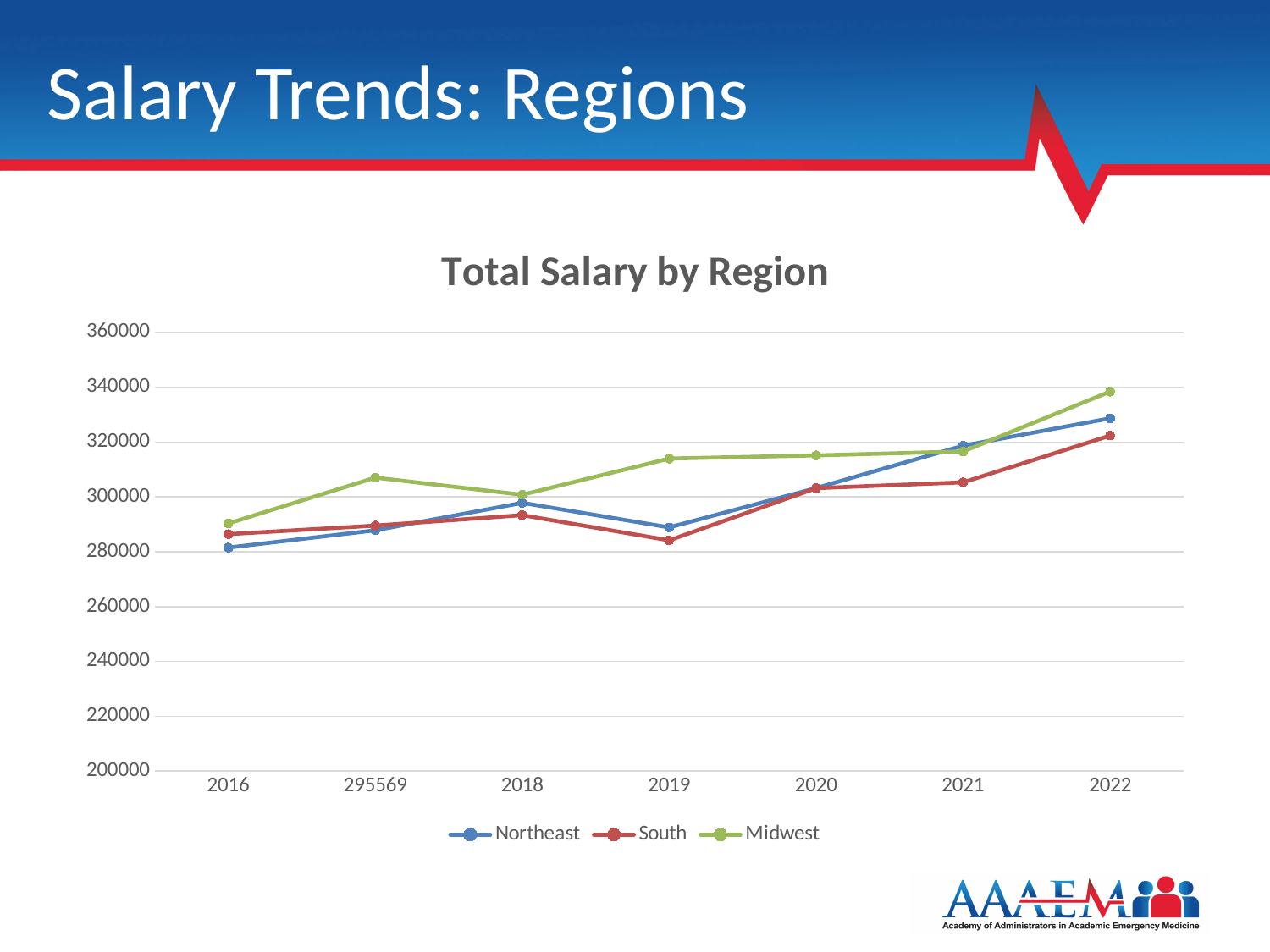
Is the value for South in 2019 greater or less than 300000? less What is the title of the chart? Total Salary by Region Which region has the highest value in 2022? Midwest How many series does the legend list? 3 In 2020, which is larger, the Northeast value or the Midwest value? Midwest How many points are plotted along the x axis for each series? 7 Which region has the highest value in 2019? Midwest Is the value for Midwest in 2022 greater or less than 320000? greater What kind of chart is shown on the slide? Line chart Which colour is used for the Midwest series? Green Is the value for Northeast in 2016 greater or less than 300000? less Does the Midwest series overall rise or fall from 2016 to 2022? Rise